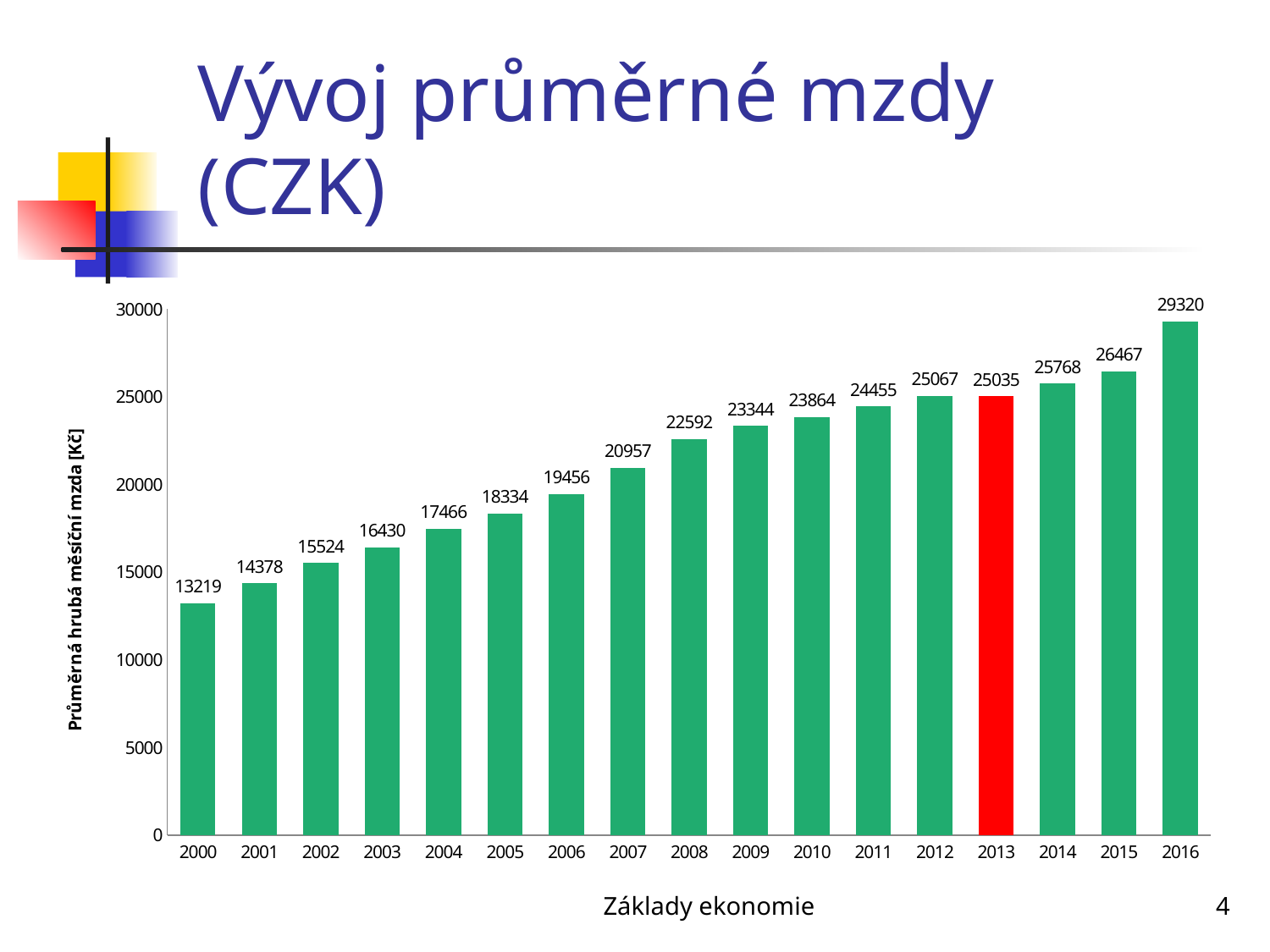
Which year has the lowest average wage? 2000 Which year's bar is coloured red instead of green? 2013 Is the value for 2010 greater or less than 25000? less What is the difference between the values for 2012 and 2013? 32 Which year has the highest average wage? 2016 What is the difference between the values for 2016 and 2015? 2853 What kind of chart is shown on the slide? bar chart Do the values generally rise or fall from 2000 to 2016? rise How many years are shown on the x axis? 17 What is the average gross monthly wage shown for 2005? 18334 Which is larger, the value for 2008 or the value for 2007? 2008 What value is shown for the year 2013? 25035